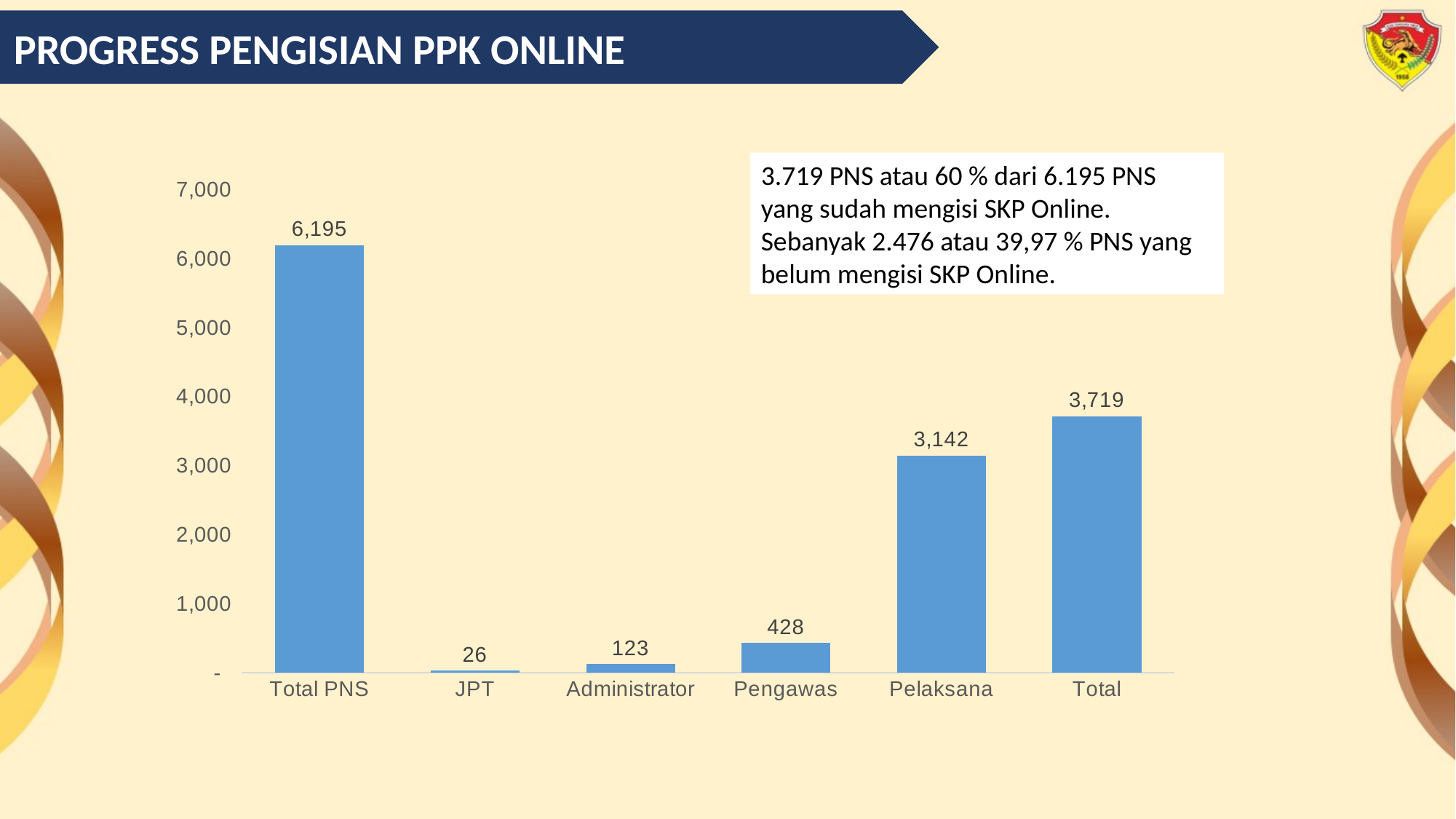
What is the value for Pengawas? 428 How many categories are shown on the x axis? 6 Which category has the lowest value? JPT What is the value for Pelaksana? 3,142 What is the value for Total PNS? 6,195 What is the value for Total? 3,719 Which category has the highest value? Total PNS What is the value for JPT? 26 What kind of chart is shown on the slide? Bar chart What is the value for Administrator? 123 What is the difference between the values for Total PNS and Total? 2,476 Which is larger, the value for Pelaksana or the value for Pengawas? Pelaksana